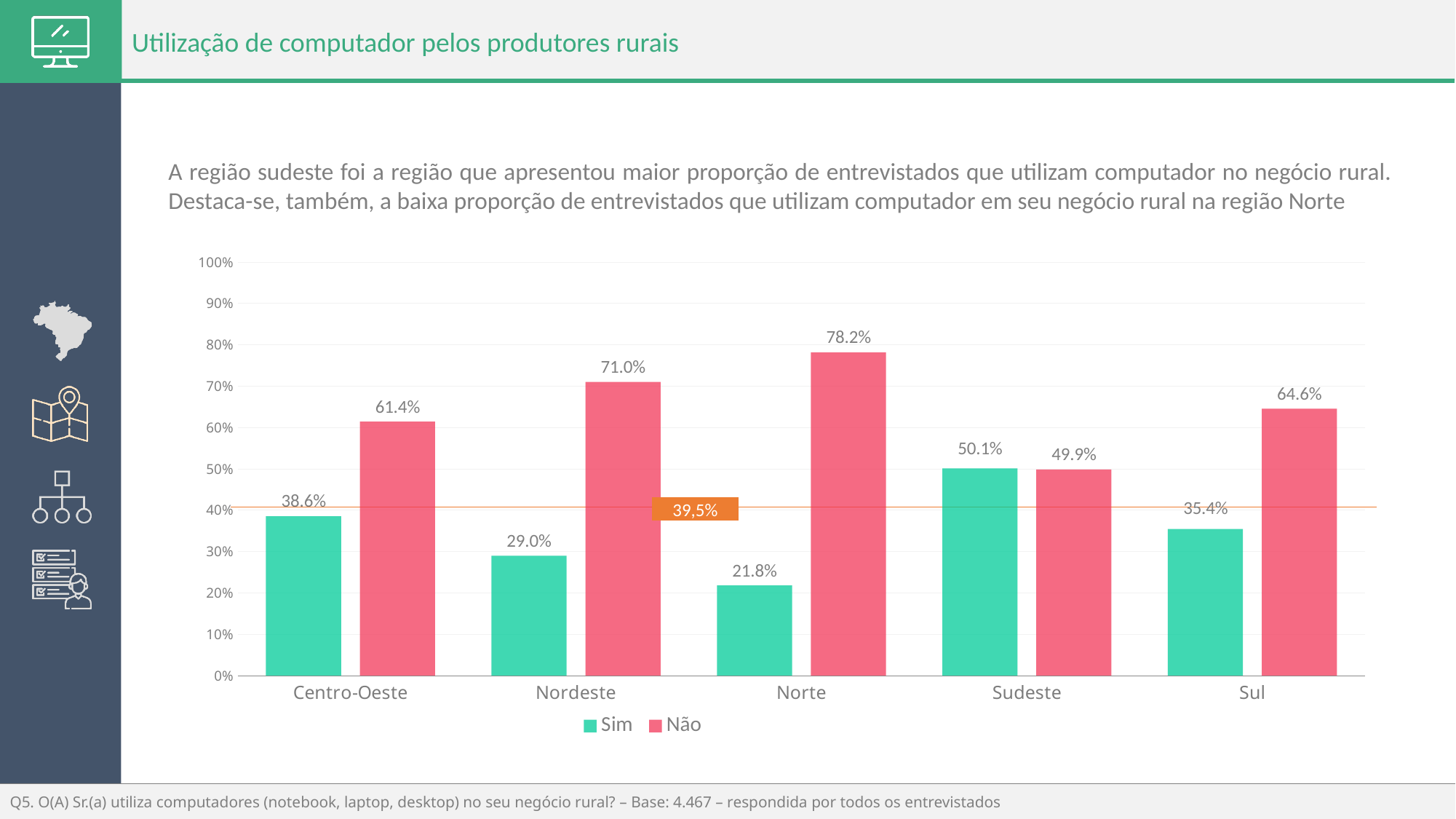
What is the 'Não' value for Sul? 64.6% Which is larger for Sul: the 'Sim' value or the 'Não' value? Não What kind of chart is shown on the slide? Bar chart What is the 'Sim' value for Sudeste? 50.1% What is the 'Não' value for Norte? 78.2% How many regions are shown on the x axis? 5 What is the 'Sim' value for Centro-Oeste? 38.6% How many series does the legend list? 2 Which region has the lowest 'Sim' value? Norte Which region has the highest 'Sim' value? Sudeste What is the difference between the 'Não' and 'Sim' values for Nordeste? 42.0% What value is shown on the orange reference line label? 39,5%